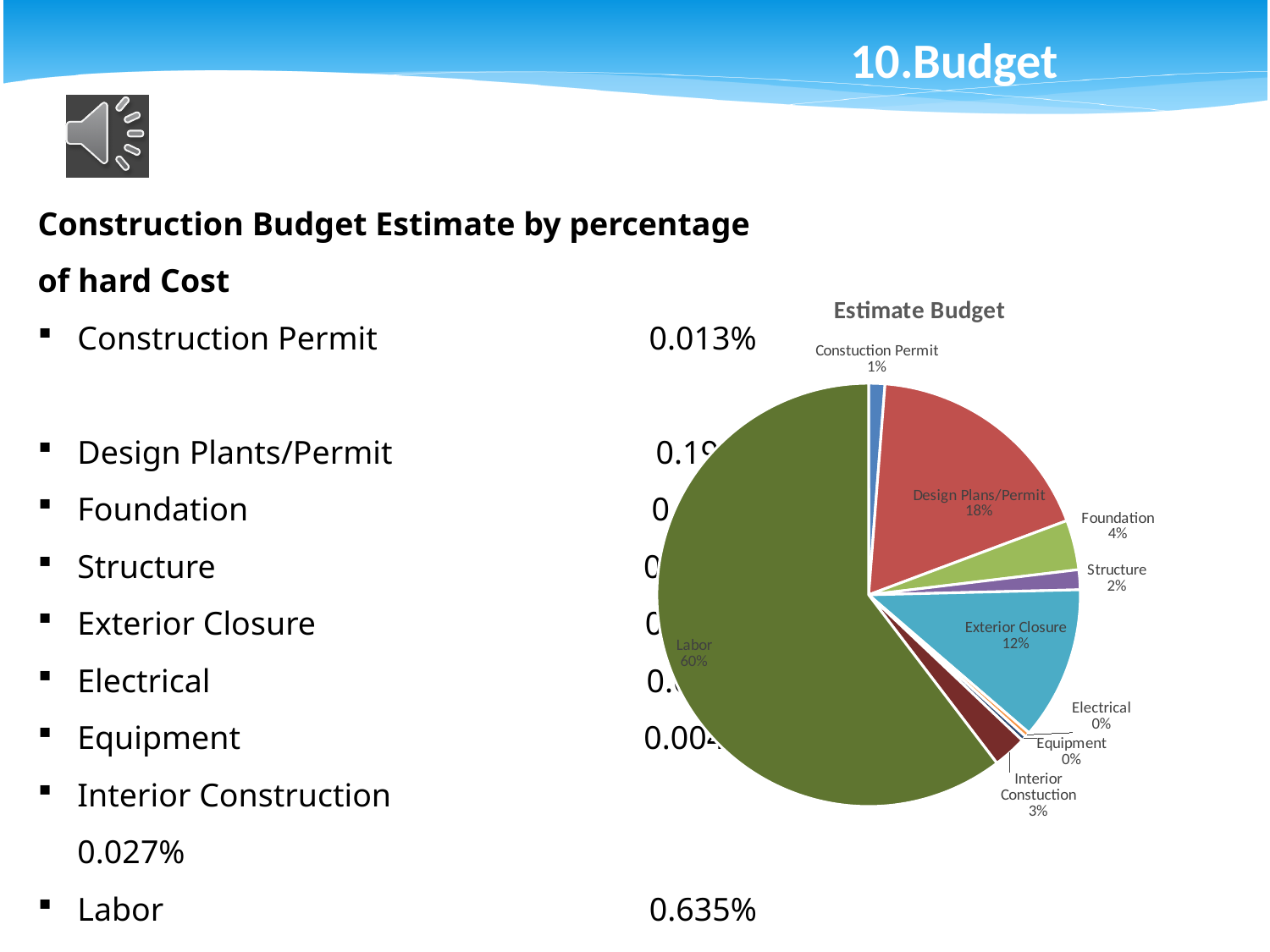
What percentage is shown for Exterior Closure in the pie chart? 12% What is the difference between the Labor and Design Plans/Permit percentages shown in the pie chart? 42% What percentage is shown for Structure in the pie chart? 2% What type of chart is shown on the slide? pie chart Which category has the largest slice in the Estimate Budget pie chart? Labor What percentage does the Labor slice show in the Estimate Budget pie chart? 60% What percentage is shown for Design Plans/Permit in the pie chart? 18% What percentage is shown for Foundation in the pie chart? 4% What is the title of the chart? Estimate Budget Which slice is larger in the pie chart, Design Plans/Permit or Exterior Closure? Design Plans/Permit What percentage is shown for Interior Construction in the pie chart? 3% How many slices (categories) are labelled in the pie chart? 9